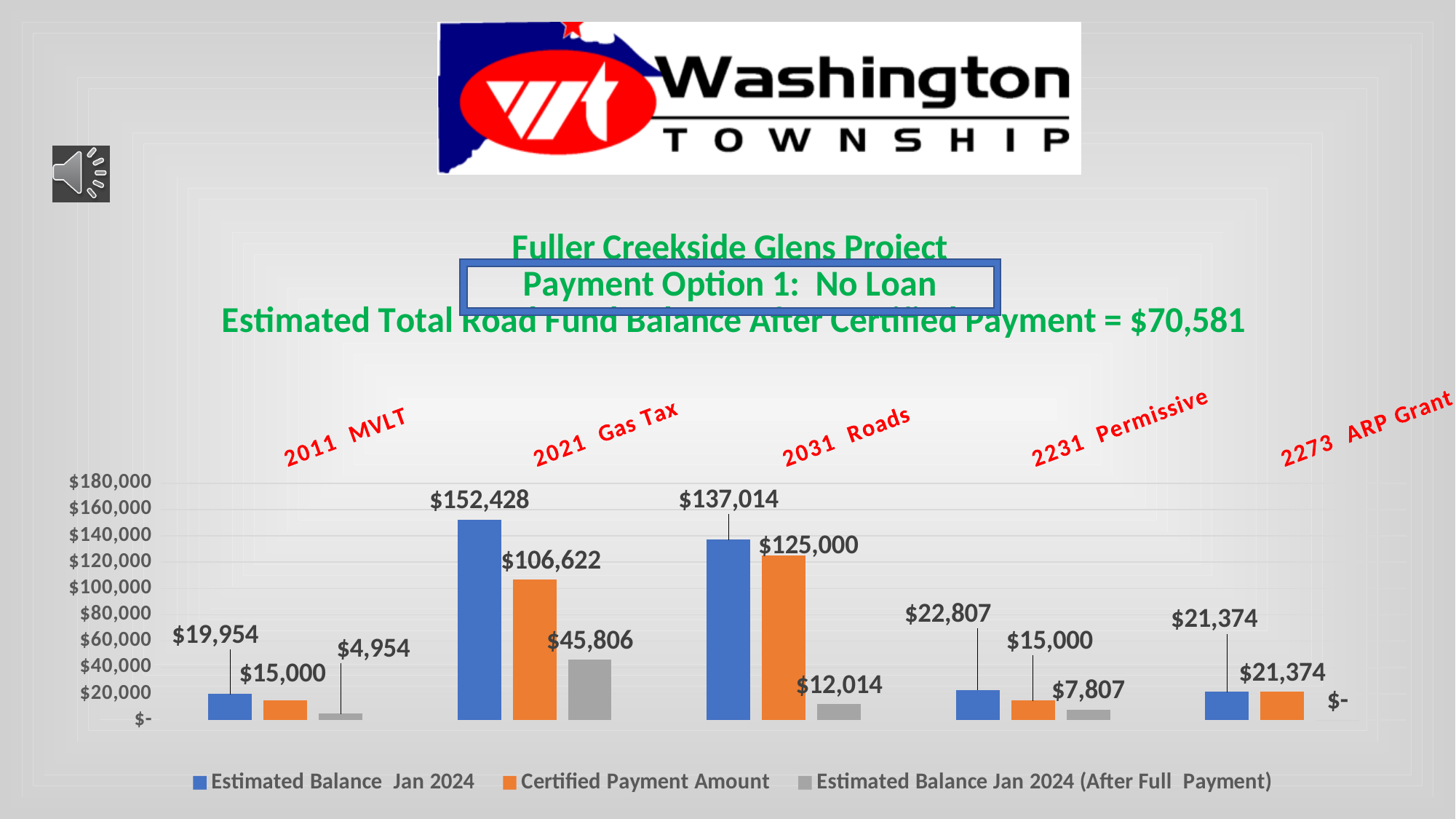
Which is larger: the Certified Payment Amount for 2031 Roads or for 2021 Gas Tax? 2031 Roads How many series does the chart legend list? 3 What is the difference between the Estimated Balance Jan 2024 and the Certified Payment Amount for 2021 Gas Tax? $45,806 What kind of chart is shown on the slide? Bar chart What is the Certified Payment Amount for 2031 Roads? $125,000 What is the Estimated Balance Jan 2024 for 2021 Gas Tax? $152,428 What is the Estimated Balance Jan 2024 (After Full Payment) for 2273 ARP Grant? $- Which category has the highest Estimated Balance Jan 2024? 2021 Gas Tax Is the Estimated Balance Jan 2024 for 2031 Roads greater or less than $120,000? greater What is the Estimated Balance Jan 2024 (After Full Payment) for 2011 MVLT? $4,954 Which category has the lowest Certified Payment Amount? 2011 MVLT and 2231 Permissive (both $15,000) How many categories are shown on the x axis of the chart? 5